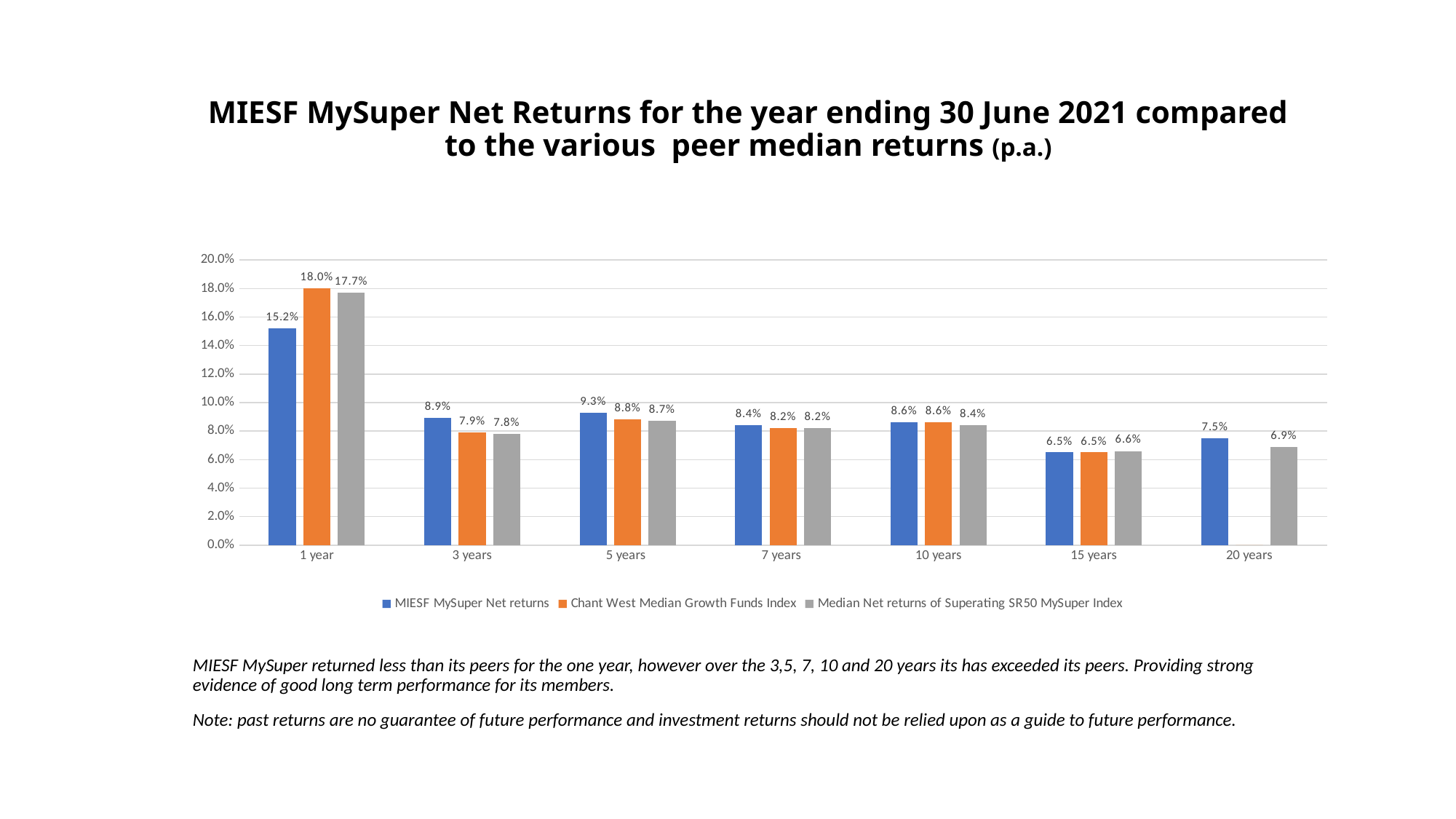
What is the Chant West Median Growth Funds Index value for 5 years? 8.8% What is the MIESF MySuper Net return for the 1 year period? 15.2% Does the MIESF MySuper Net return rise or fall from 1 year to 3 years? Fall What is the difference between the Chant West Median Growth Funds Index and the MIESF MySuper Net return for 1 year? 2.8% Which period has the highest MIESF MySuper Net return? 1 year For 3 years, which is larger: the MIESF MySuper Net return or the Chant West Median Growth Funds Index? MIESF MySuper Net returns Which period has the lowest Chant West Median Growth Funds Index value? 15 years What is the Median Net returns of Superating SR50 MySuper Index value for 20 years? 6.9% Which colour represents the Chant West Median Growth Funds Index? Orange What kind of chart is shown on the slide? Bar chart How many series does the legend list? 3 How many time periods are shown on the x axis? 7